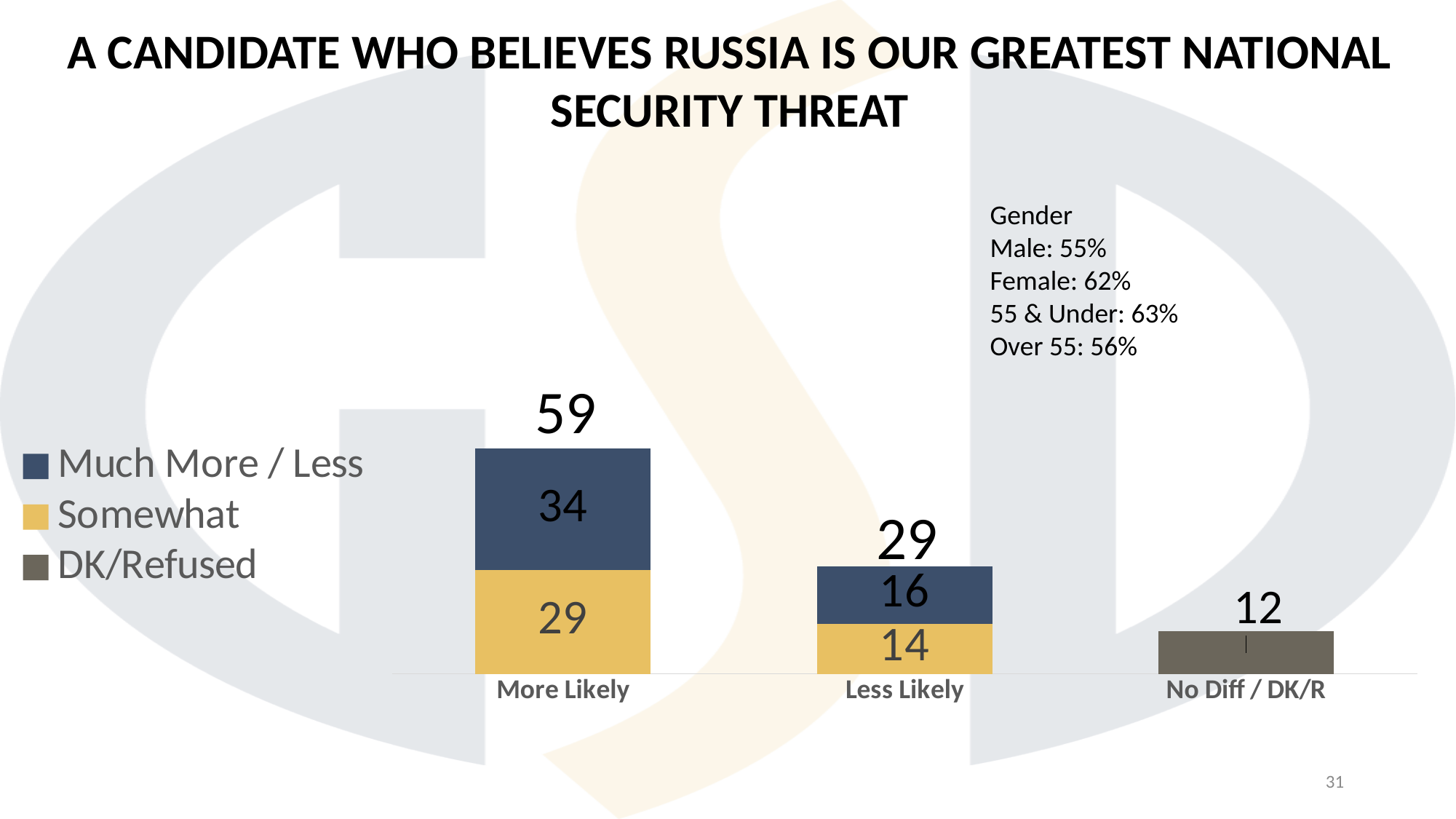
What is the 'Somewhat' value for the Less Likely bar? 14 What is the total of the Less Likely stacked bar? 29 What is the difference between the More Likely total and the Less Likely total? 30 Which is larger: the 'Somewhat' value for More Likely or the 'Somewhat' value for Less Likely? More Likely Which category has the highest total? More Likely What kind of chart is shown on the slide? Stacked bar chart How many categories are shown on the x axis? 3 How many series does the legend list? 3 What is the 'Much More / Less' value for the More Likely bar? 34 What is the value shown for the No Diff / DK/R bar? 12 What is the total of the More Likely stacked bar? 59 Which category has the lowest total? No Diff / DK/R